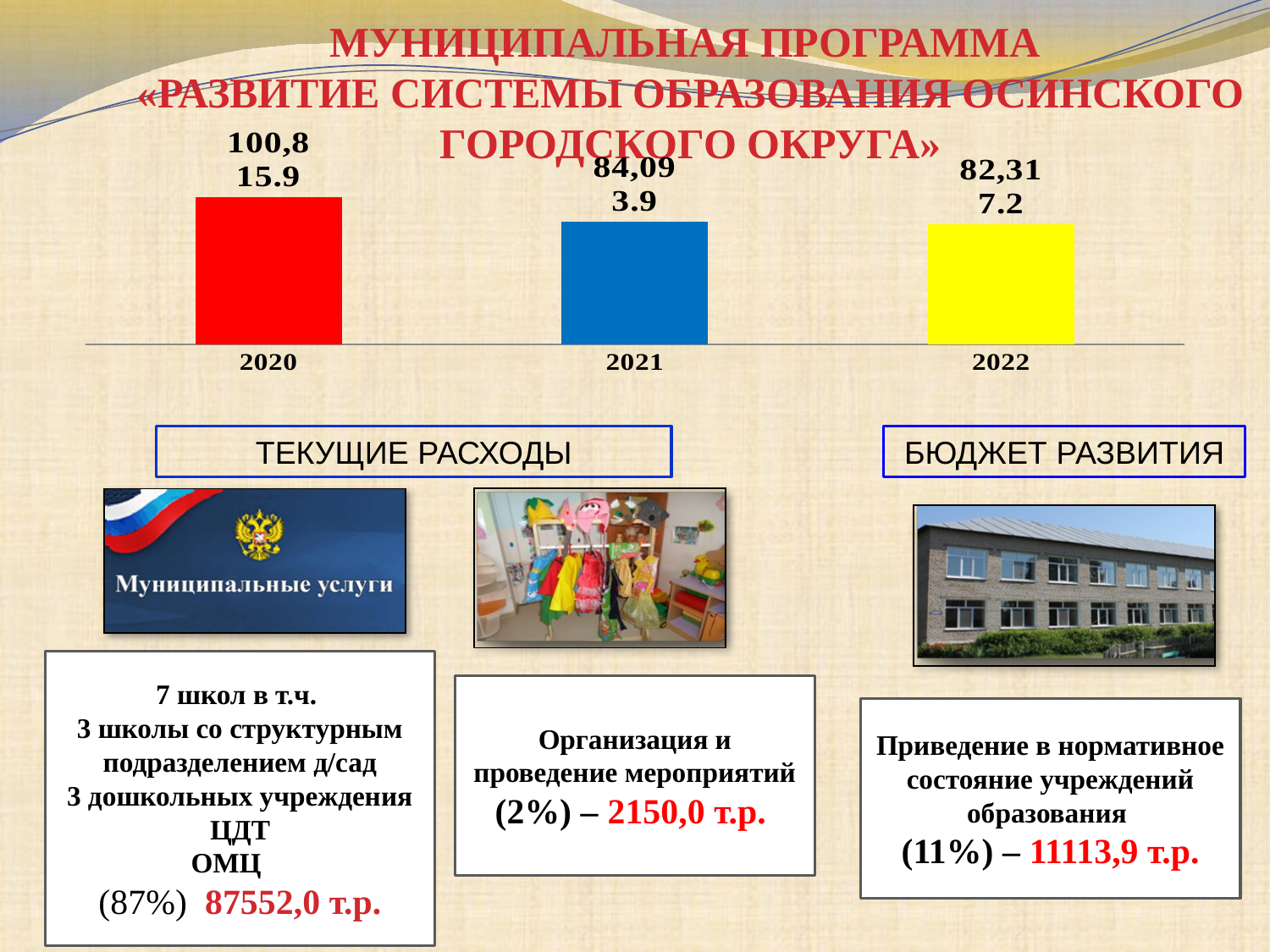
What is the upper value printed above the 2021 bar? 84,09 Which years are labelled on the x axis of the chart? 2020, 2021, 2022 What is the lower value printed above the 2020 bar? 15.9 What kind of chart is shown on the slide? bar chart How many bars does the chart have? 3 What colour is the 2021 bar? blue Which year has the tallest bar in the chart? 2020 What is the lower value printed above the 2021 bar? 3.9 What is the upper value printed above the 2020 bar? 100,8 What is the lower value printed above the 2022 bar? 7.2 What is the upper value printed above the 2022 bar? 82,31 Which bar is taller, 2020 or 2021? 2020